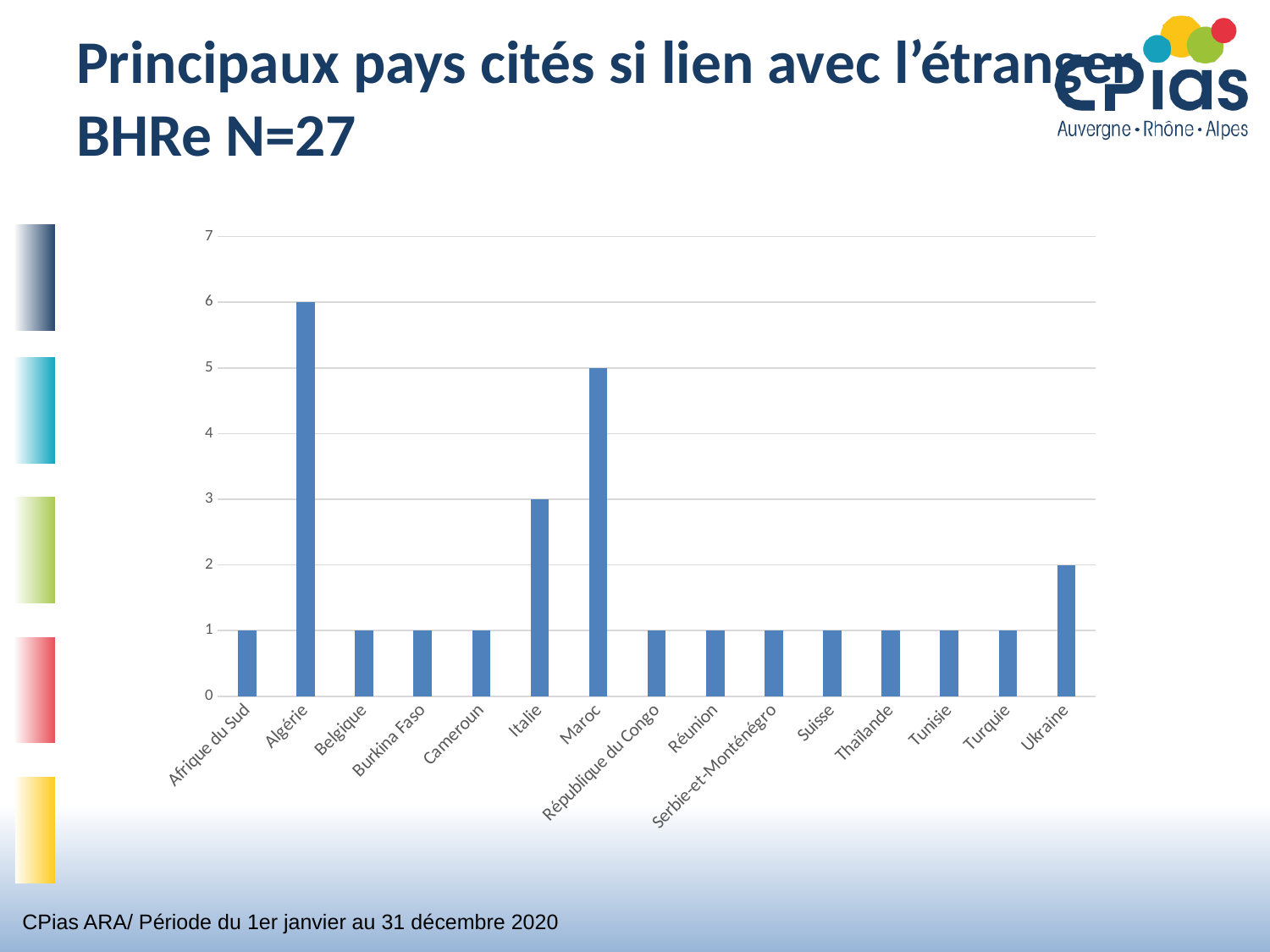
What is the value for Algérie? 6 Which is larger, the value for Italie or the value for Ukraine? Italie What is the highest value shown on the y axis of the chart? 7 What is the difference between the values for Algérie and Maroc? 1 Is the value for Maroc greater or less than 4? greater How many countries are shown on the x axis of the chart? 15 What type of chart is shown on the slide? Bar chart What is the value for Italie? 3 What is the value for Tunisie? 1 What is the value for Maroc? 5 What is the value for Ukraine? 2 Which country has the highest bar in the chart? Algérie